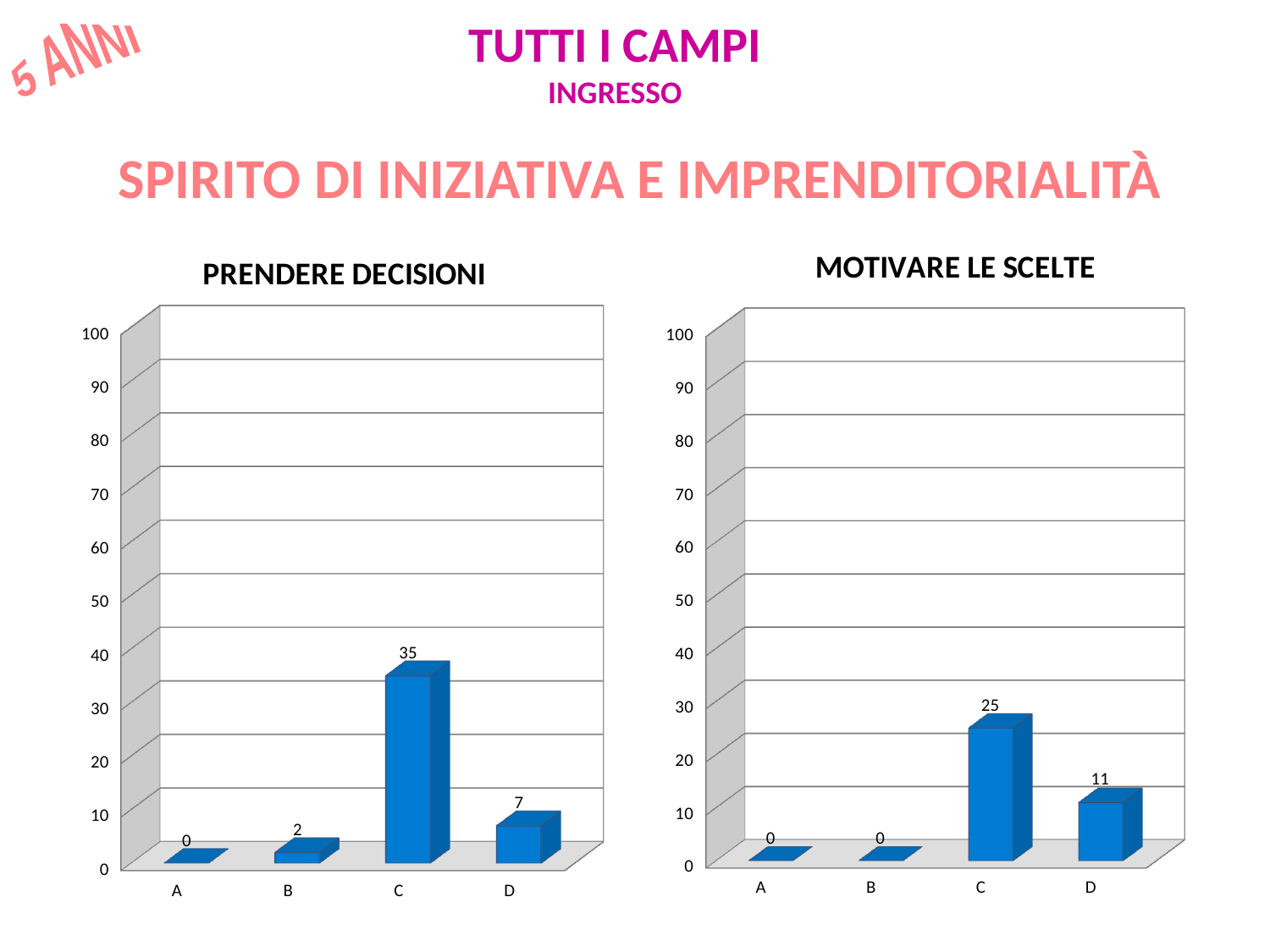
In the MOTIVARE LE SCELTE chart, which category has the highest value? C In the PRENDERE DECISIONI chart, what is the value for category C? 35 In the MOTIVARE LE SCELTE chart, what is the value for category C? 25 In the PRENDERE DECISIONI chart, which category has the highest value? C In the PRENDERE DECISIONI chart, what is the difference between the values for C and D? 28 What kind of chart is the MOTIVARE LE SCELTE chart? bar chart In the MOTIVARE LE SCELTE chart, is the value for C greater or less than 20? greater In the PRENDERE DECISIONI chart, what is the value for category B? 2 In the MOTIVARE LE SCELTE chart, what is the value for category D? 11 How many categories are shown on the x axis of the PRENDERE DECISIONI chart? 4 In the PRENDERE DECISIONI chart, which category has the lowest value? A In the MOTIVARE LE SCELTE chart, what is the difference between the values for C and D? 14